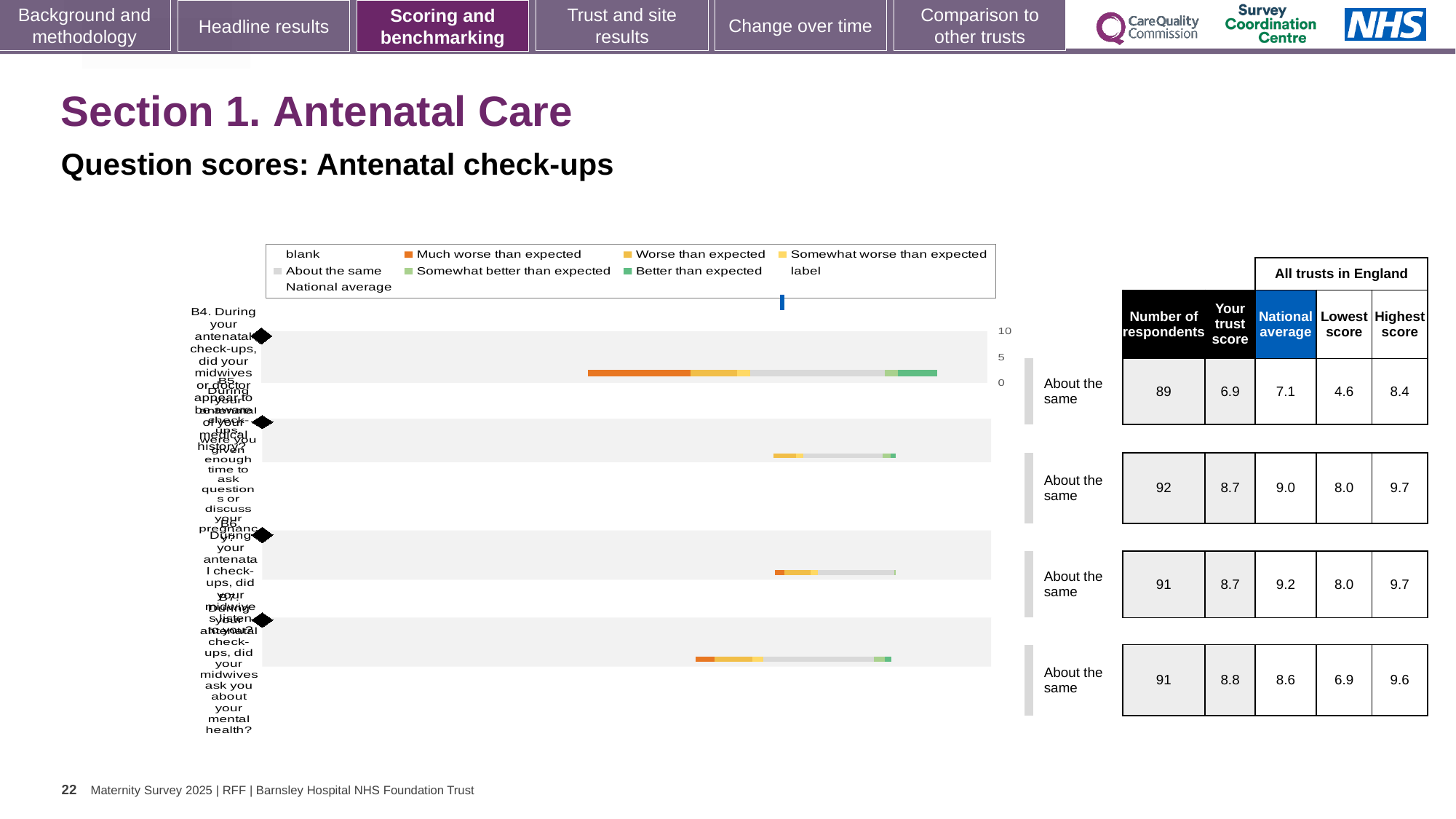
What is the highest score among all trusts in England for question B4 (the first row)? 8.4 For question B7 (the last row), which is larger: the trust score or the national average? the trust score What is the 'Your trust score' for question B4 (the first row)? 6.9 How many questions (bars) are plotted in the chart? 4 Which question has the highest 'Your trust score'? B7 What is the national average for question B7 (the last row)? 8.6 What benchmark rating is shown for question B6 (the third row)? About the same For question B4 (the first row), what is the difference between the national average and the trust score? 0.2 What colour represents 'Much worse than expected' in the legend? orange Which question has the lowest 'Your trust score'? B4 What kind of chart is shown on the slide? bar chart How many respondents answered question B5 (the second row)? 92